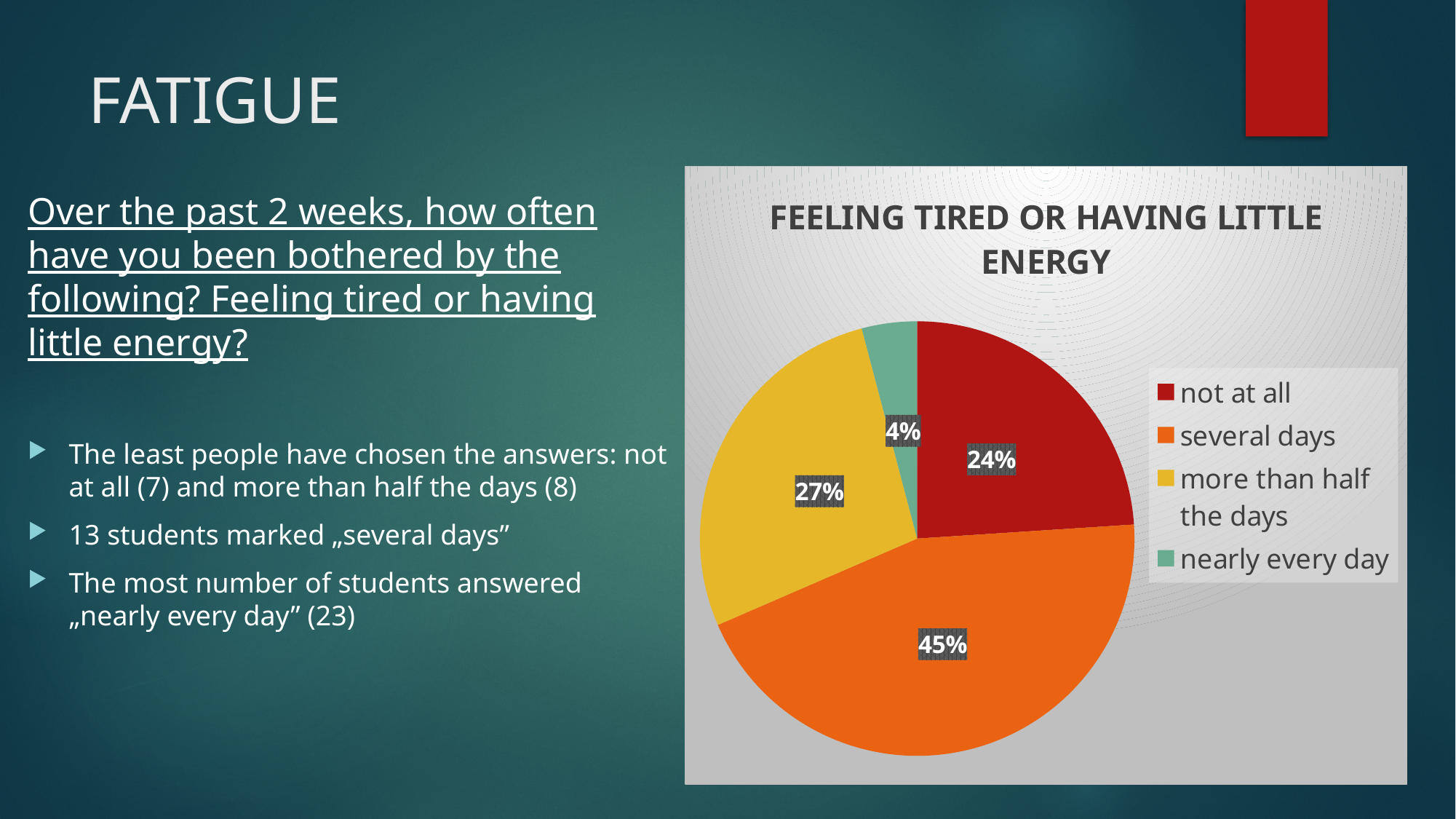
Which slice is larger: "more than half the days" or "not at all"? more than half the days Which category has the largest slice of the pie? several days How many categories does the legend of the pie chart list? 4 What is the difference in percentage points between the "several days" slice and the "not at all" slice? 21 What percentage of the pie is labelled for "more than half the days"? 27% What colour is the slice for "nearly every day"? green What is the title of the chart? FEELING TIRED OR HAVING LITTLE ENERGY What percentage of the pie is labelled for "not at all"? 24% What percentage of the pie is labelled for "nearly every day"? 4% What type of chart is shown on the slide? pie chart What percentage of the pie is labelled for "several days"? 45% Which category has the smallest slice of the pie? nearly every day